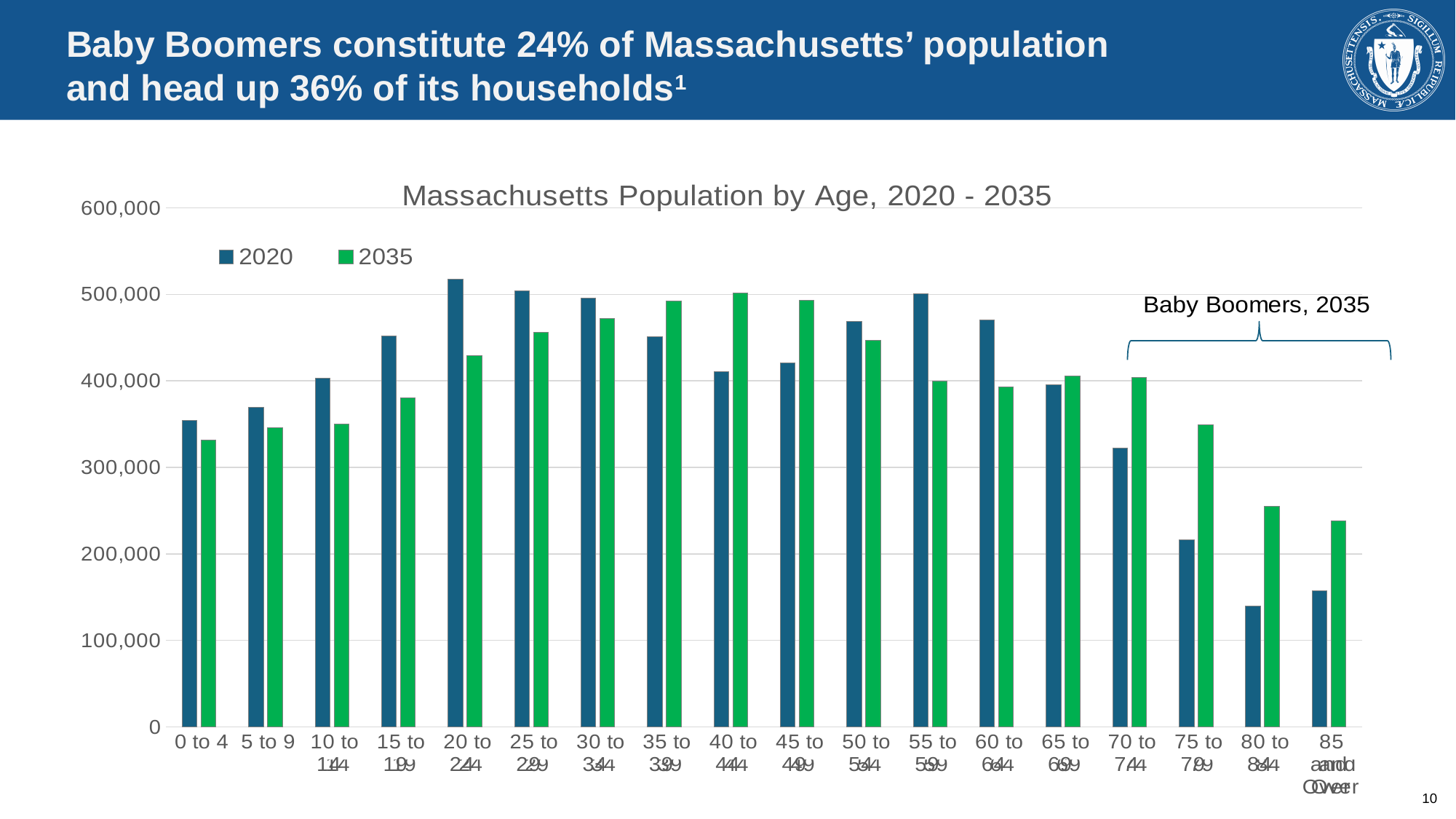
Is the 2035 value for 75 to 79 greater or less than 400,000? less Which age group has the lowest 2020 population? 80 to 84 Is the 2020 value for 80 to 84 greater or less than 200,000? less How many age groups are shown on the x axis? 18 For the 0 to 4 age group, which is larger, the 2020 value or the 2035 value? 2020 Which age group has the lowest 2035 population? 85 and Over For the 40 to 44 age group, which is larger, the 2020 value or the 2035 value? 2035 What kind of chart is shown on the slide? Bar chart Which age groups does the 'Baby Boomers, 2035' bracket span? 70 to 74 through 85 and Over Which age group has the highest 2020 population? 20 to 24 Is the 2020 value for 20 to 24 greater or less than 500,000? greater How many series does the legend list? 2